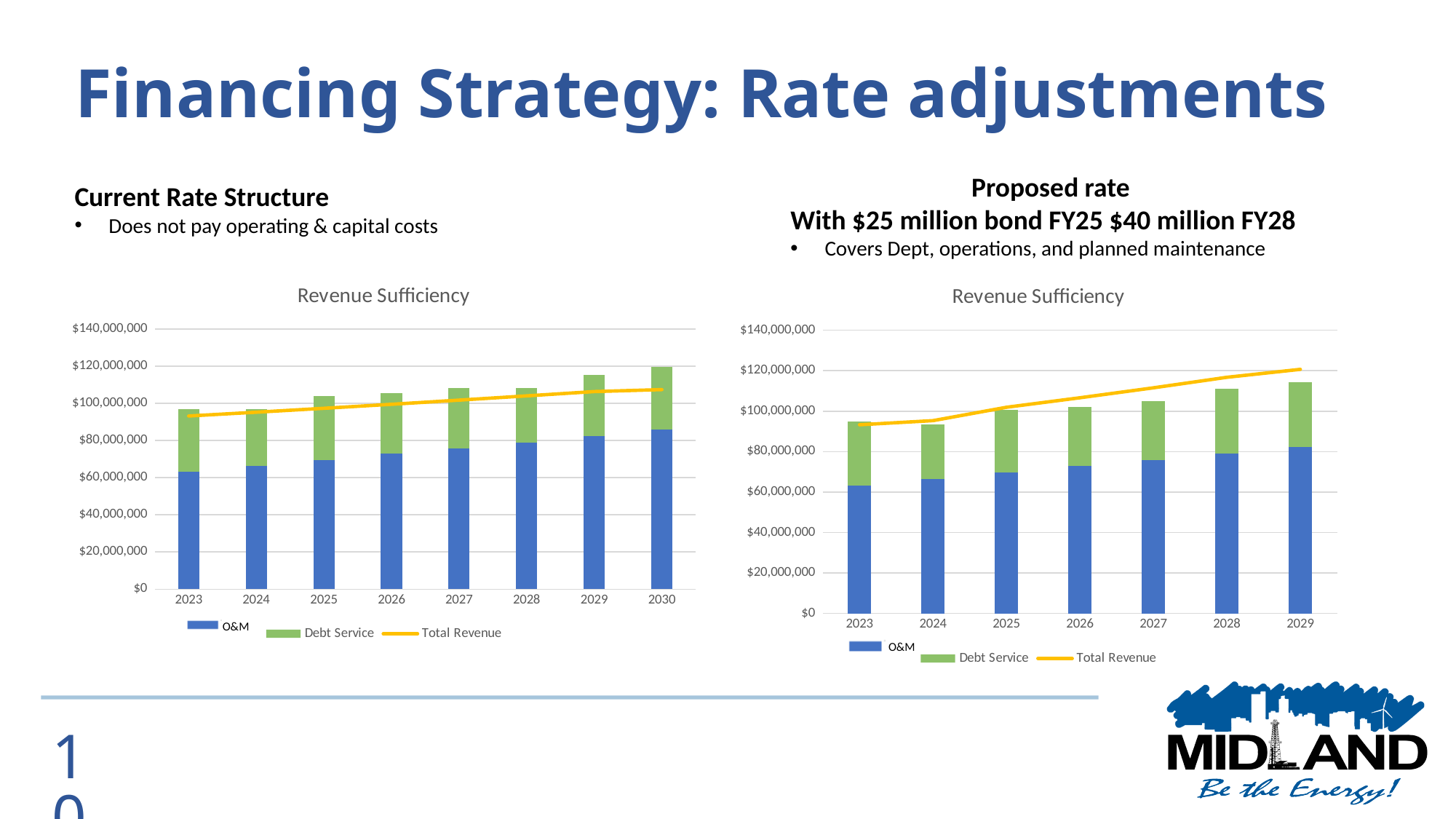
In the left chart, is the O&M value for 2030 greater or less than $80,000,000? greater In the right chart, which year has the shortest stacked bar? 2024 How many years are shown on the x axis of the right chart under 'Proposed rate'? 7 In the left chart, which year has the tallest stacked bar? 2030 In the left chart, is the O&M value for 2023 greater or less than $80,000,000? less In the right chart, is the Total Revenue value for 2023 greater or less than $100,000,000? less In the right chart, does the Total Revenue line rise or fall from 2023 to 2029? rises Which series is shown in green in both charts? Debt Service How many series does the legend of the left chart list? 3 How many years are shown on the x axis of the left chart? 8 What type of chart is the left chart under 'Current Rate Structure'? Stacked bar chart with a line